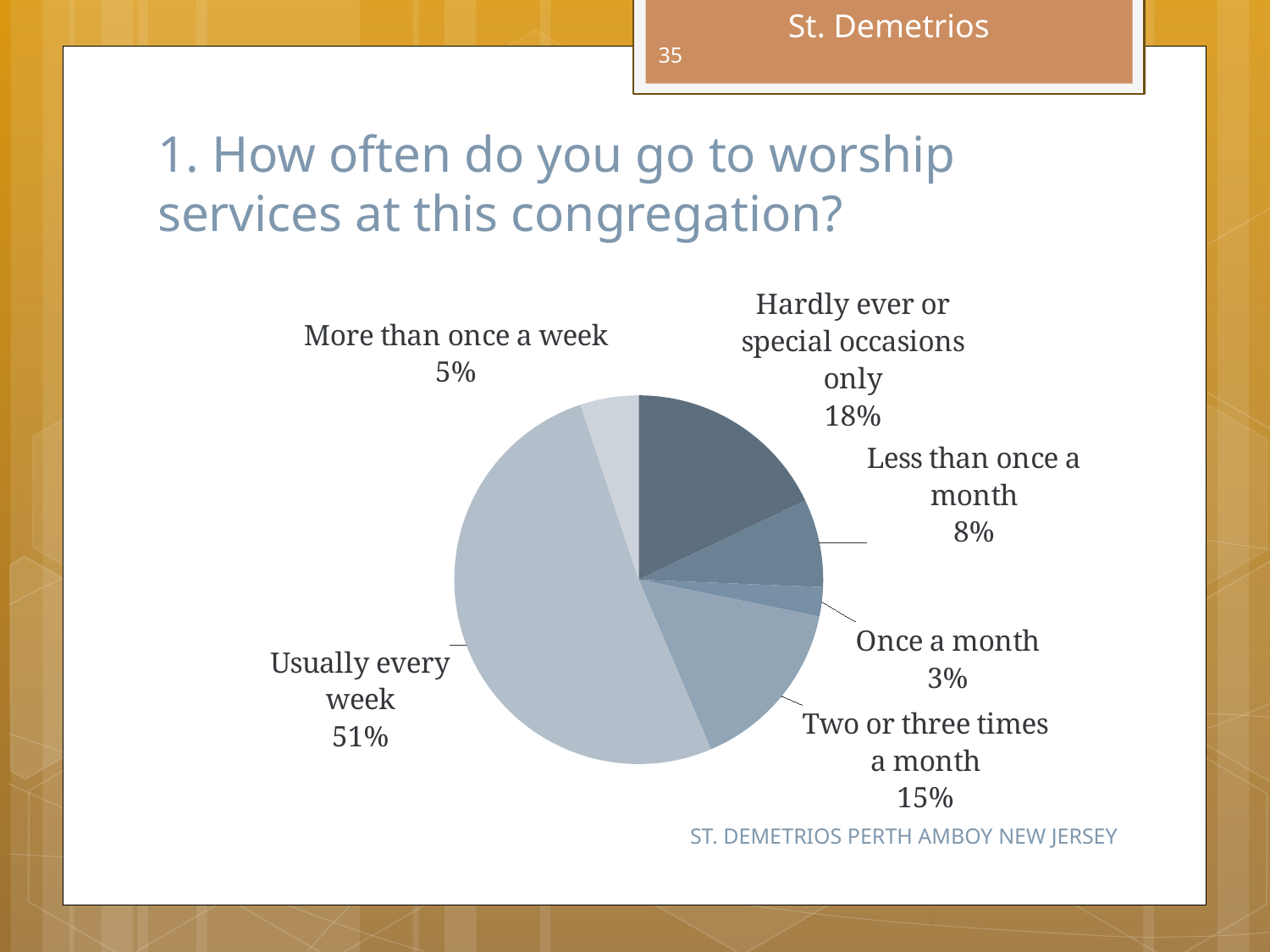
What percentage of respondents attend two or three times a month? 15% What is the difference in percentage points between 'Usually every week' and 'Hardly ever or special occasions only'? 33 Which is larger: the share for 'Two or three times a month' or the share for 'Less than once a month'? Two or three times a month What percentage of respondents attend hardly ever or on special occasions only? 18% What question does the chart title say the chart is about? How often do you go to worship services at this congregation? What percentage of respondents attend more than once a week? 5% Which attendance category has the smallest share of the pie? Once a month What percentage of respondents attend less than once a month? 8% What kind of chart is shown on the slide? pie chart How many categories are shown in the pie chart? 6 What share of respondents go to worship services usually every week? 51% Which attendance category has the largest share of the pie? Usually every week